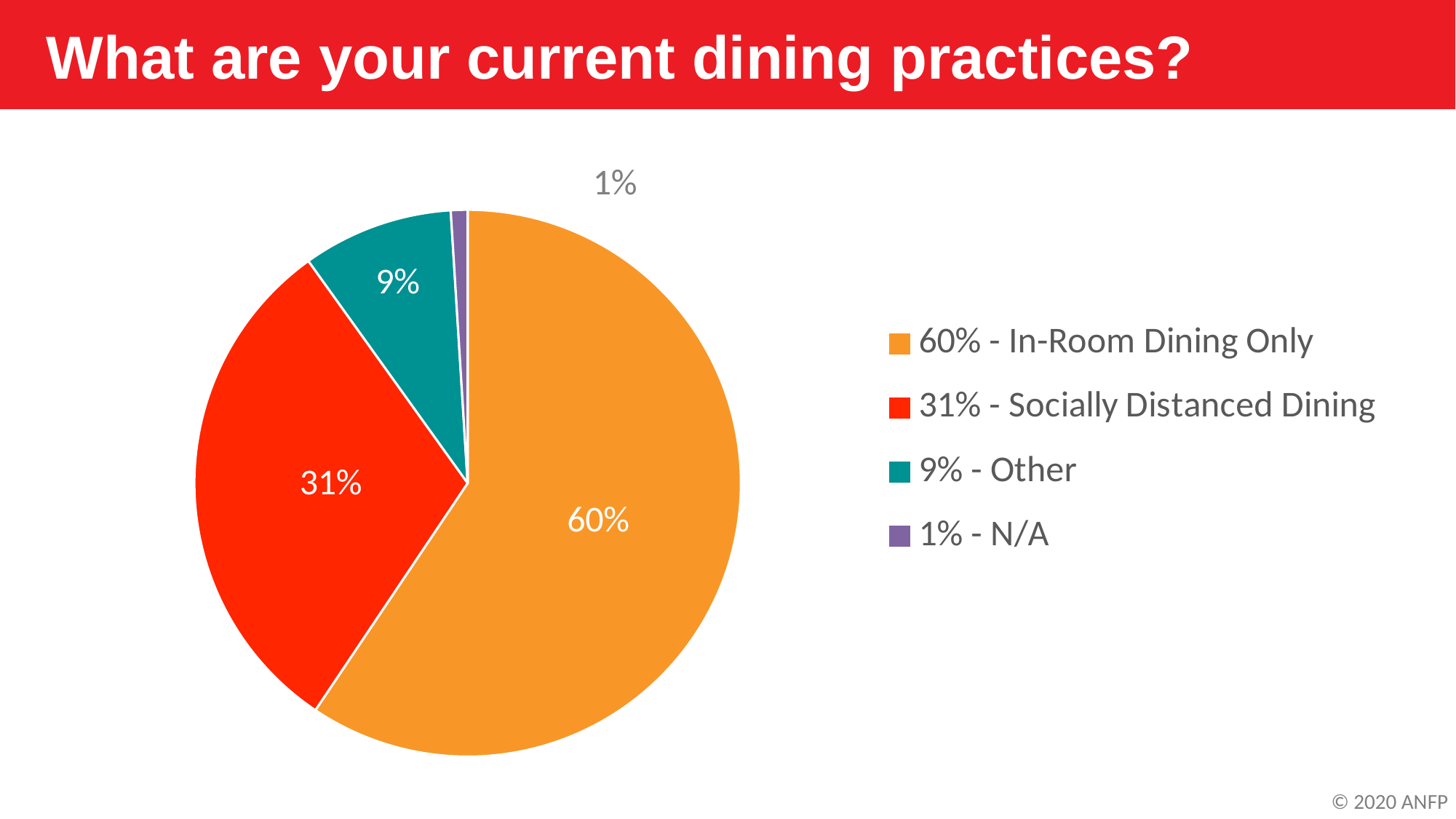
What percentage of respondents reported In-Room Dining Only? 60% What percentage of respondents reported Socially Distanced Dining? 31% What percentage is shown for N/A? 1% What is the difference in percentage points between In-Room Dining Only and Socially Distanced Dining? 29 Which dining practice has the largest share of the pie? In-Room Dining Only What is the title of the slide containing the chart? What are your current dining practices? What percentage is shown for the Other category? 9% Which category has the smallest slice of the pie? N/A What type of chart is shown on the slide? pie chart Which is larger, the share for Socially Distanced Dining or the share for Other? Socially Distanced Dining What colour is the slice representing Other? teal How many categories are shown in the pie chart? 4